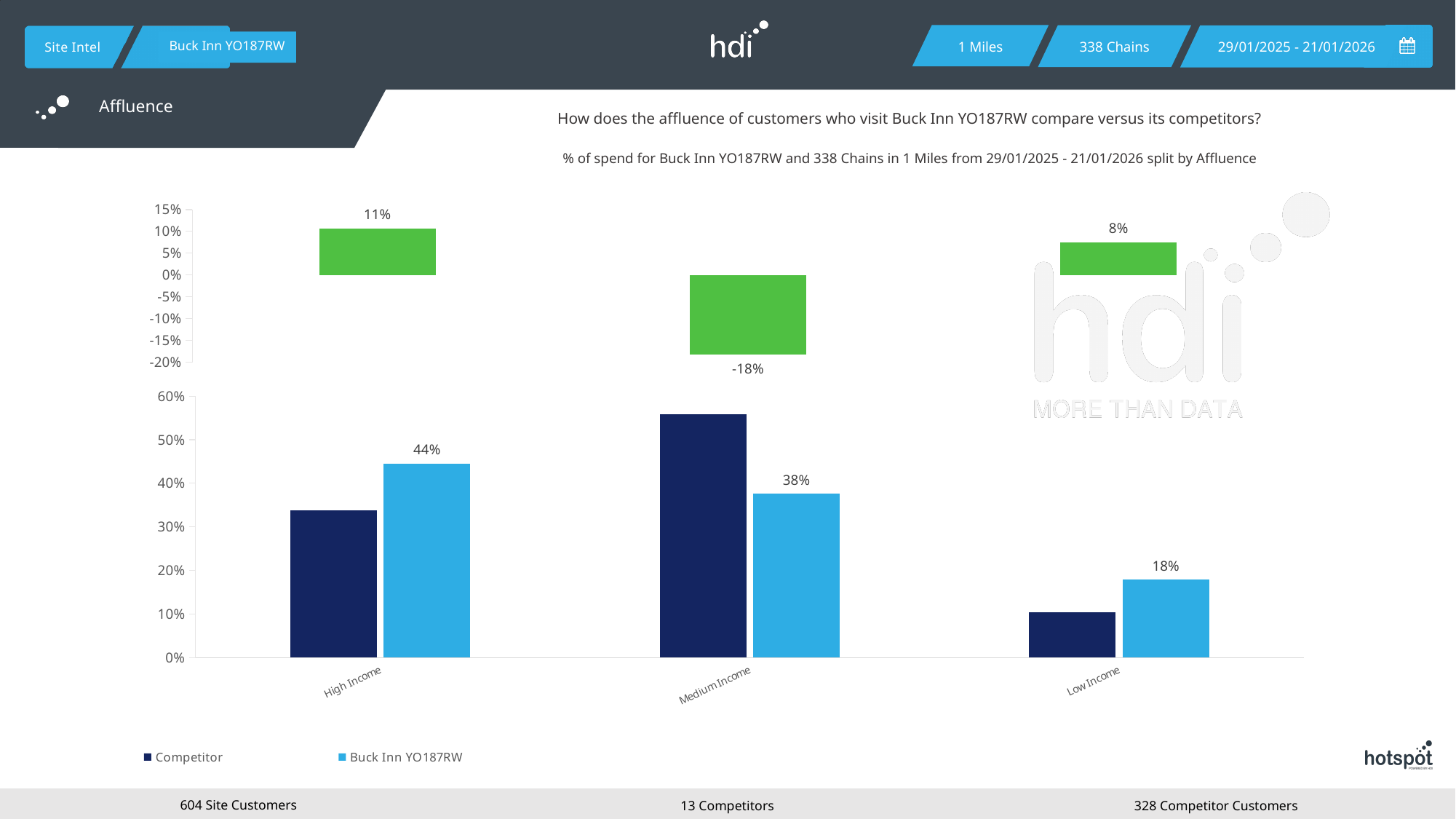
In the bottom chart, what is the value for Buck Inn YO187RW in the Medium Income category? 38% How many series does the legend of the bottom chart list? 2 In the top chart, what is the value shown for Medium Income? -18% What kind of chart is the bottom chart? Bar chart In the top chart, what is the value shown for Low Income? 8% In the bottom chart, is the Competitor value for Medium Income greater or less than 50%? greater In the bottom chart, what is the value for Buck Inn YO187RW in the High Income category? 44% In the bottom chart, which is larger for Medium Income: Competitor or Buck Inn YO187RW? Competitor In the bottom chart, what is the difference between the Buck Inn YO187RW values for High Income and Low Income? 26% In the top chart, which category has the highest value? High Income In the bottom chart, what is the value for Buck Inn YO187RW in the Low Income category? 18% In the bottom chart, which category has the lowest Buck Inn YO187RW value? Low Income